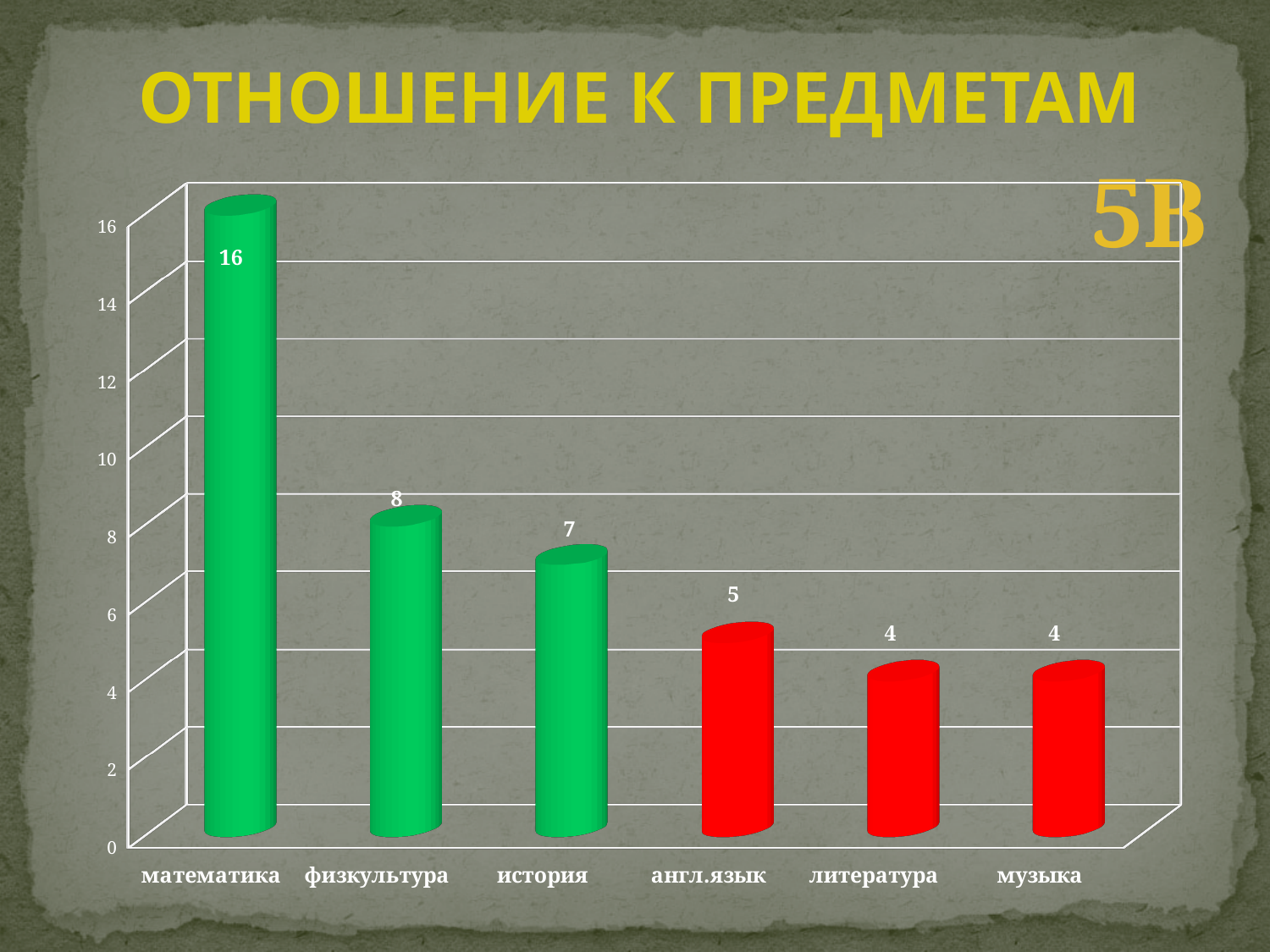
Do the values rise or fall from left to right along the x axis? fall What is the value for англ.язык? 5 How many categories are shown on the x axis? 6 What is the value for физкультура? 8 Which is larger, the value for физкультура or the value for литература? физкультура What colour are the bars for англ.язык, литература and музыка? red Which category has the highest value? математика What is the difference between the values for математика and история? 9 What kind of chart is shown on the slide? bar chart What is the title of the slide? ОТНОШЕНИЕ К ПРЕДМЕТАМ Is the value for история greater or less than 6? greater What is the value for математика? 16